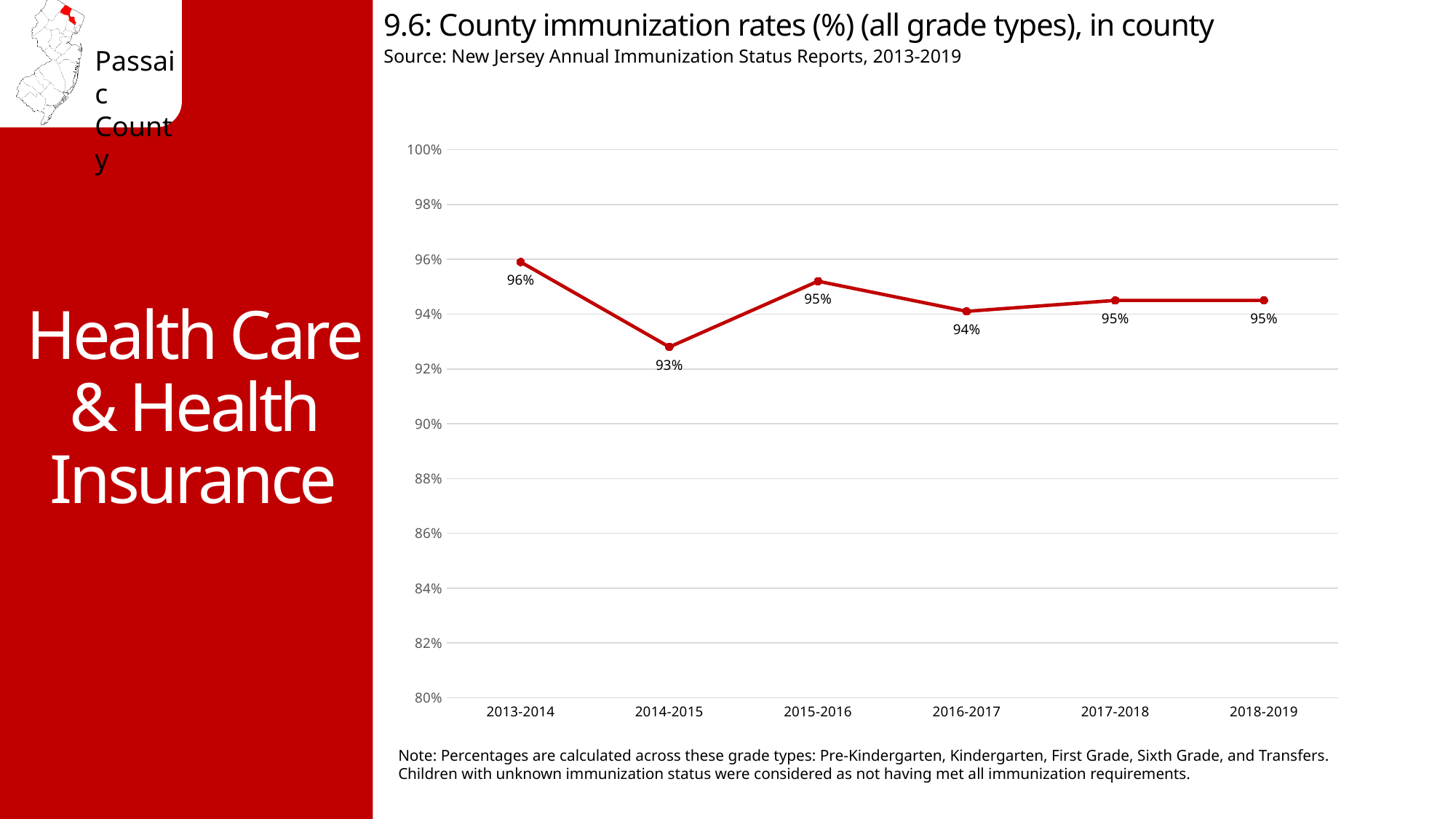
What kind of chart is shown on the slide? line chart How many school years are plotted on the chart? 6 What is the county immunization rate for 2016-2017? 94% Which year has a higher immunization rate, 2015-2016 or 2016-2017? 2015-2016 Does the immunization rate rise or fall from 2013-2014 to 2014-2015? fall What is the county immunization rate for 2014-2015? 93% Which school year has the lowest immunization rate? 2014-2015 What is the difference between the immunization rate in 2013-2014 and in 2014-2015? 3 percentage points What is the county immunization rate for 2018-2019? 95% Is the value for 2014-2015 greater or less than 94%? less What is the county immunization rate for 2013-2014? 96% Which school year has the highest immunization rate? 2013-2014